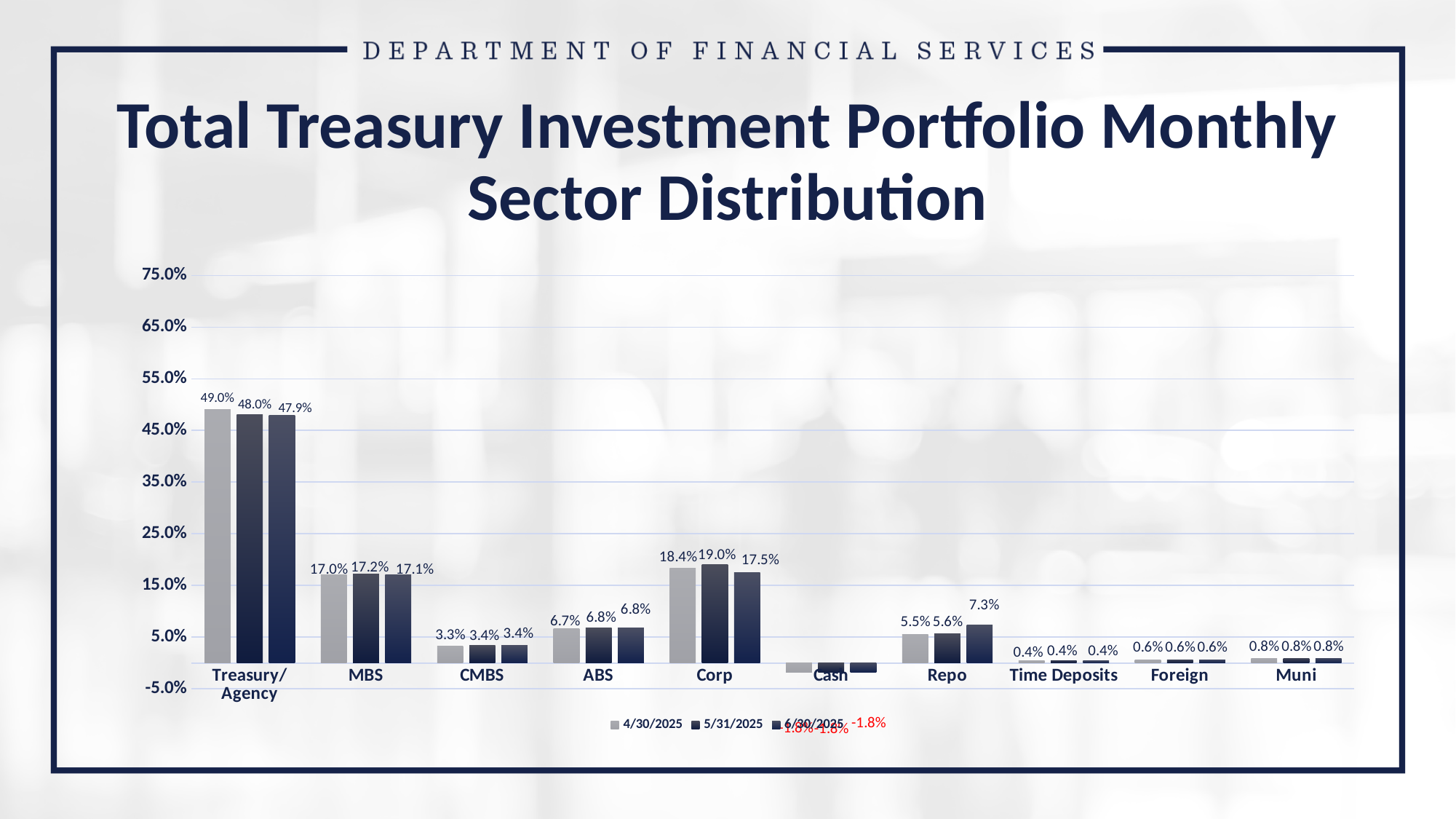
Does the Treasury/Agency value rise or fall from 4/30/2025 to 6/30/2025? fall What is the value for Cash on 6/30/2025? -1.8% What kind of chart is shown on the slide? bar chart Which is larger, the MBS value on 5/31/2025 or the MBS value on 4/30/2025? 5/31/2025 Which sector has the lowest value on 4/30/2025? Cash What is the value for Repo on 6/30/2025? 7.3% How many series does the legend list? 3 Which sector has the highest value on 6/30/2025? Treasury/Agency What is the value for Corp on 5/31/2025? 19.0% What is the value for Treasury/Agency on 4/30/2025? 49.0% What is the difference between the Corp values on 5/31/2025 and 6/30/2025? 1.5% How many sector categories are shown on the x axis? 10